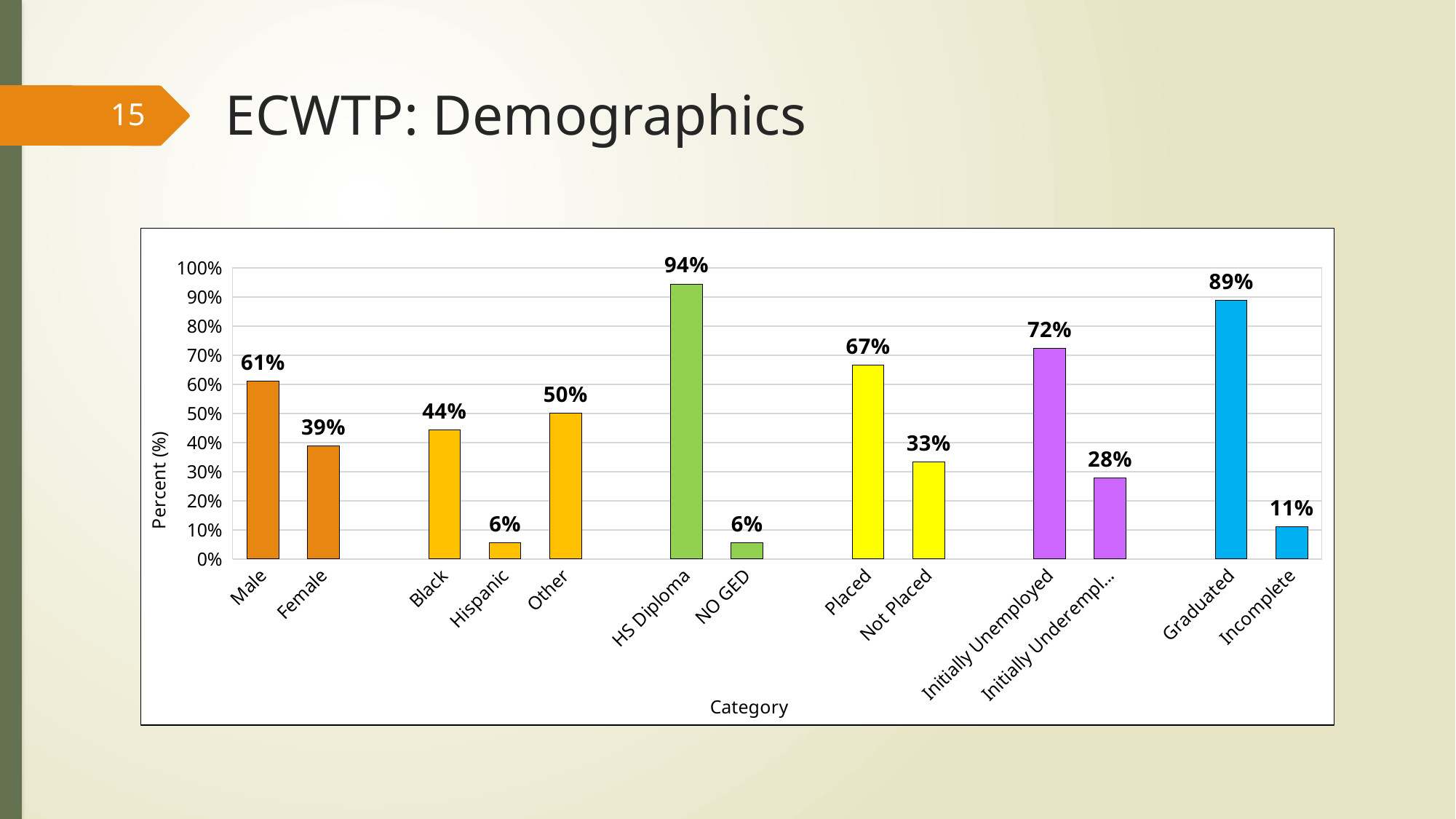
What is the difference between the values for Placed and Not Placed? 34% Is the value for Female greater or less than 50%? less What is the difference between the values for Graduated and Incomplete? 78% Which category has the highest value? HS Diploma Which is larger, the value for Black or the value for Other? Other What is the value for Initially Unemployed? 72% What kind of chart is shown on the slide? bar chart What is the label of the vertical axis? Percent (%) What is the value for Incomplete? 11% How many categories are shown on the x axis? 13 What is the value for Male? 61% What is the value for HS Diploma? 94%